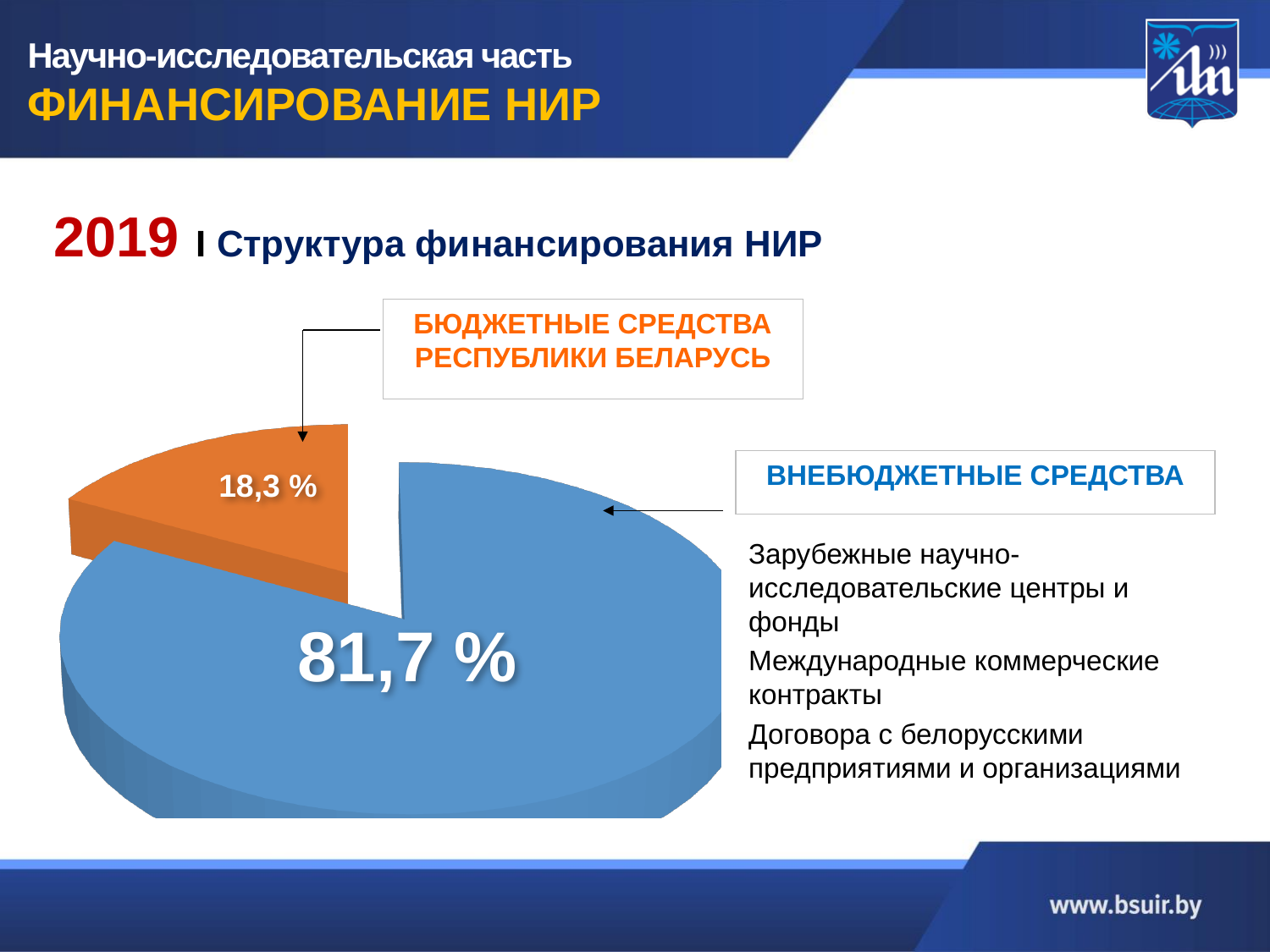
What share of the pie is labelled БЮДЖЕТНЫЕ СРЕДСТВА РЕСПУБЛИКИ БЕЛАРУСЬ? 18,3 % Which is larger, the share for БЮДЖЕТНЫЕ СРЕДСТВА or the share for ВНЕБЮДЖЕТНЫЕ СРЕДСТВА? ВНЕБЮДЖЕТНЫЕ СРЕДСТВА What share of the pie is labelled ВНЕБЮДЖЕТНЫЕ СРЕДСТВА? 81,7 % Which slice of the pie is the smallest? БЮДЖЕТНЫЕ СРЕДСТВА РЕСПУБЛИКИ БЕЛАРУСЬ Which year does the pie chart on the slide refer to? 2019 What colour is the slice representing БЮДЖЕТНЫЕ СРЕДСТВА РЕСПУБЛИКИ БЕЛАРУСЬ? orange What kind of chart is shown on the slide? pie chart What colour is the slice representing ВНЕБЮДЖЕТНЫЕ СРЕДСТВА? blue What is the difference in percentage points between the ВНЕБЮДЖЕТНЫЕ СРЕДСТВА slice and the БЮДЖЕТНЫЕ СРЕДСТВА slice? 63,4 Which slice of the pie is the largest? ВНЕБЮДЖЕТНЫЕ СРЕДСТВА How many slices does the pie chart have? 2